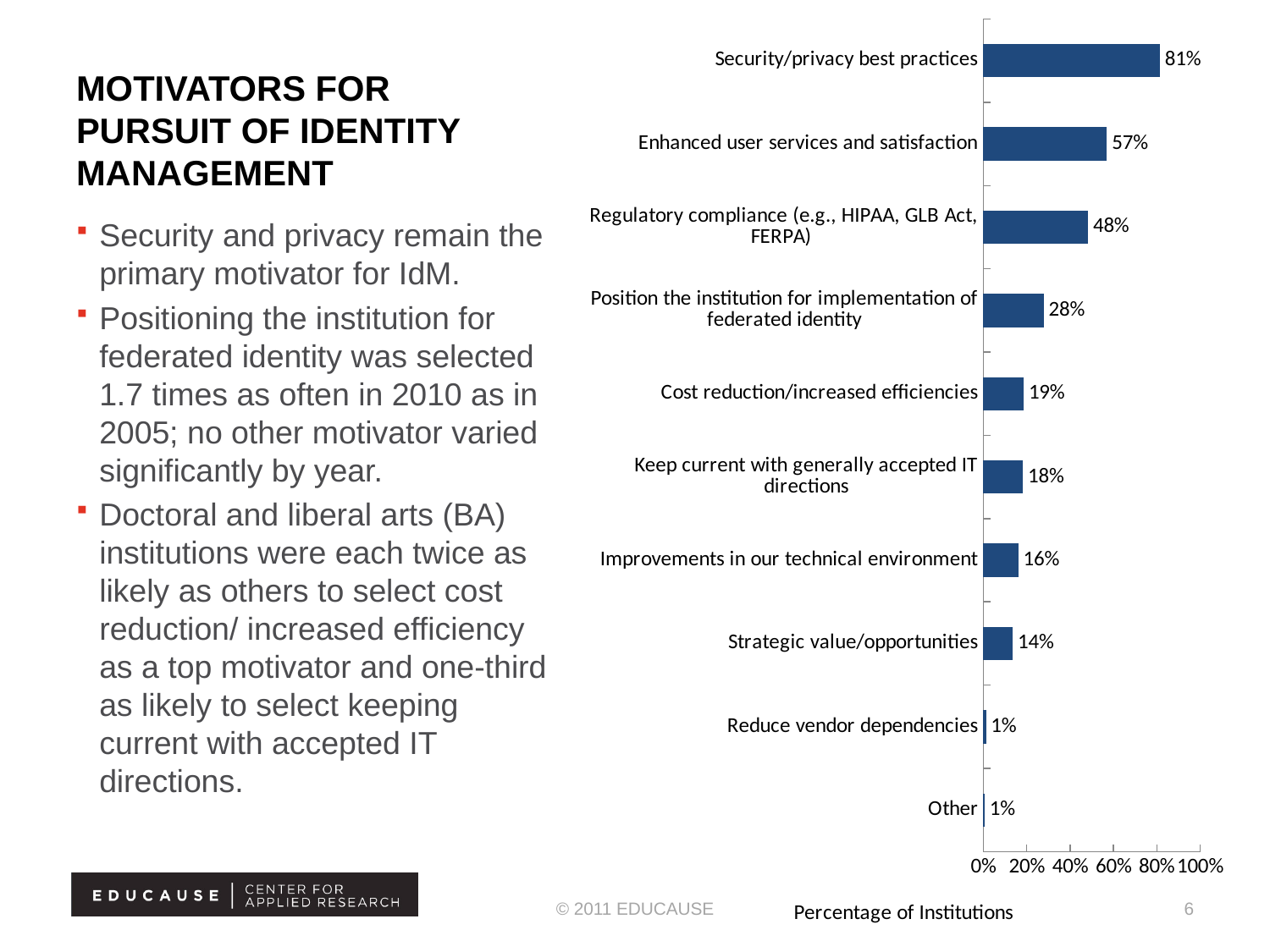
What is the difference between Regulatory compliance (e.g., HIPAA, GLB Act, FERPA) and Strategic value/opportunities? 34% Which motivator has the highest percentage of institutions? Security/privacy best practices What type of chart is shown on the slide? Bar chart Which is larger: Improvements in our technical environment or Strategic value/opportunities? Improvements in our technical environment What percentage of institutions selected Security/privacy best practices as a motivator? 81% What percentage is shown for Cost reduction/increased efficiencies? 19% What is the value for Position the institution for implementation of federated identity? 28% What is the value for Enhanced user services and satisfaction? 57% What is the difference between Security/privacy best practices and Enhanced user services and satisfaction? 24% What is the label on the horizontal axis of the chart? Percentage of Institutions How many motivator categories are shown in the chart? 10 Is the value for Regulatory compliance (e.g., HIPAA, GLB Act, FERPA) greater or less than 40%? greater